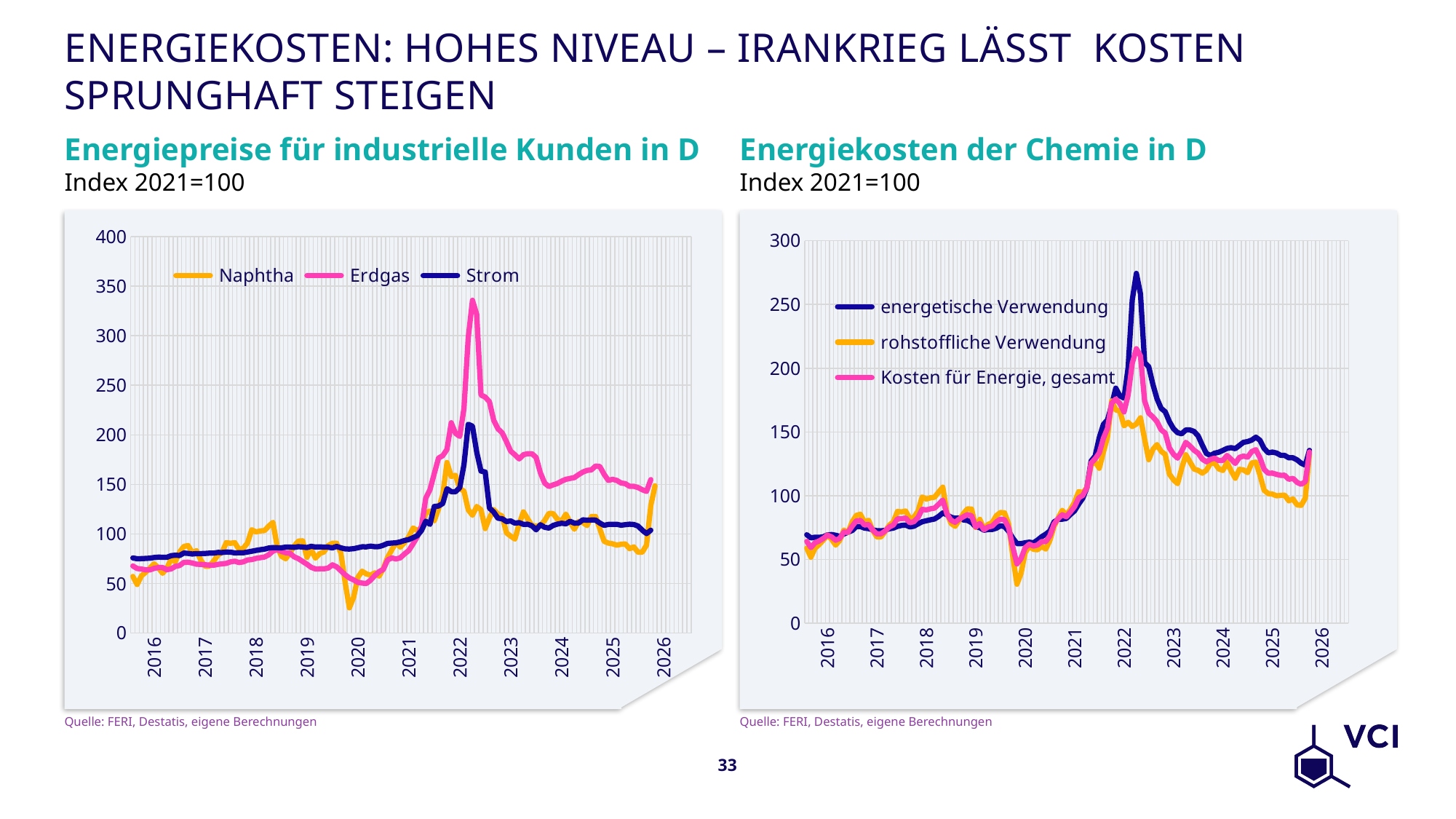
In the left chart 'Energiepreise für industrielle Kunden in D', is the peak value of Erdgas in 2022 greater or less than 300? greater How many series does the legend of the left chart 'Energiepreise für industrielle Kunden in D' list? 3 In the right chart 'Energiekosten der Chemie in D', which series reaches the highest peak? energetische Verwendung What kind of chart is the left chart, 'Energiepreise für industrielle Kunden in D'? line chart What index base is stated under both chart titles on the slide? Index 2021=100 In the right chart 'Energiekosten der Chemie in D', is the lowest value of rohstoffliche Verwendung in 2020 greater or less than 50? less In the right chart 'Energiekosten der Chemie in D', is the peak value of energetische Verwendung in 2022 greater or less than 250? greater What kind of chart is the right chart, 'Energiekosten der Chemie in D'? line chart In the left chart 'Energiepreise für industrielle Kunden in D', does the Erdgas series rise or fall between its 2022 peak and 2025? fall In the left chart 'Energiepreise für industrielle Kunden in D', which series reaches the highest peak? Erdgas How many series does the legend of the right chart 'Energiekosten der Chemie in D' list? 3